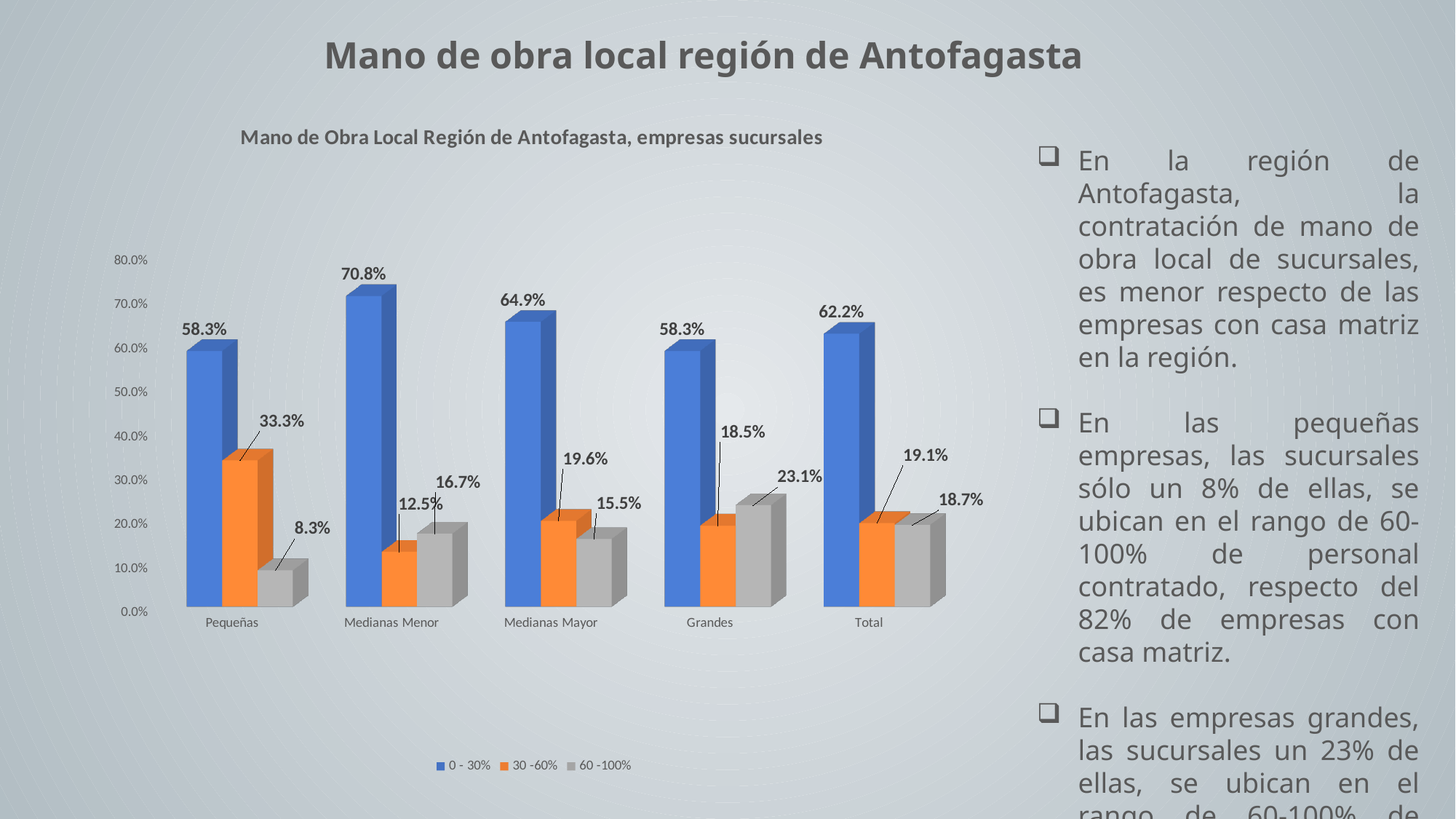
How many series does the legend list? 3 For Grandes, which is larger: the 30 -60% value or the 60 -100% value? 60 -100% Which category has the highest value in the 0 - 30% series? Medianas Menor What is the value of the 0 - 30% series for Total? 62.2% How many categories are shown on the x axis? 5 What is the value of the 60 -100% series for Grandes? 23.1% What is the title of the chart? Mano de Obra Local Región de Antofagasta, empresas sucursales What is the value of the 0 - 30% series for Medianas Menor? 70.8% What is the value of the 30 -60% series for Pequeñas? 33.3% Which category has the lowest value in the 60 -100% series? Pequeñas What kind of chart is shown on the slide? Bar chart What is the difference between the 0 - 30% value and the 30 -60% value for Medianas Mayor? 45.3%